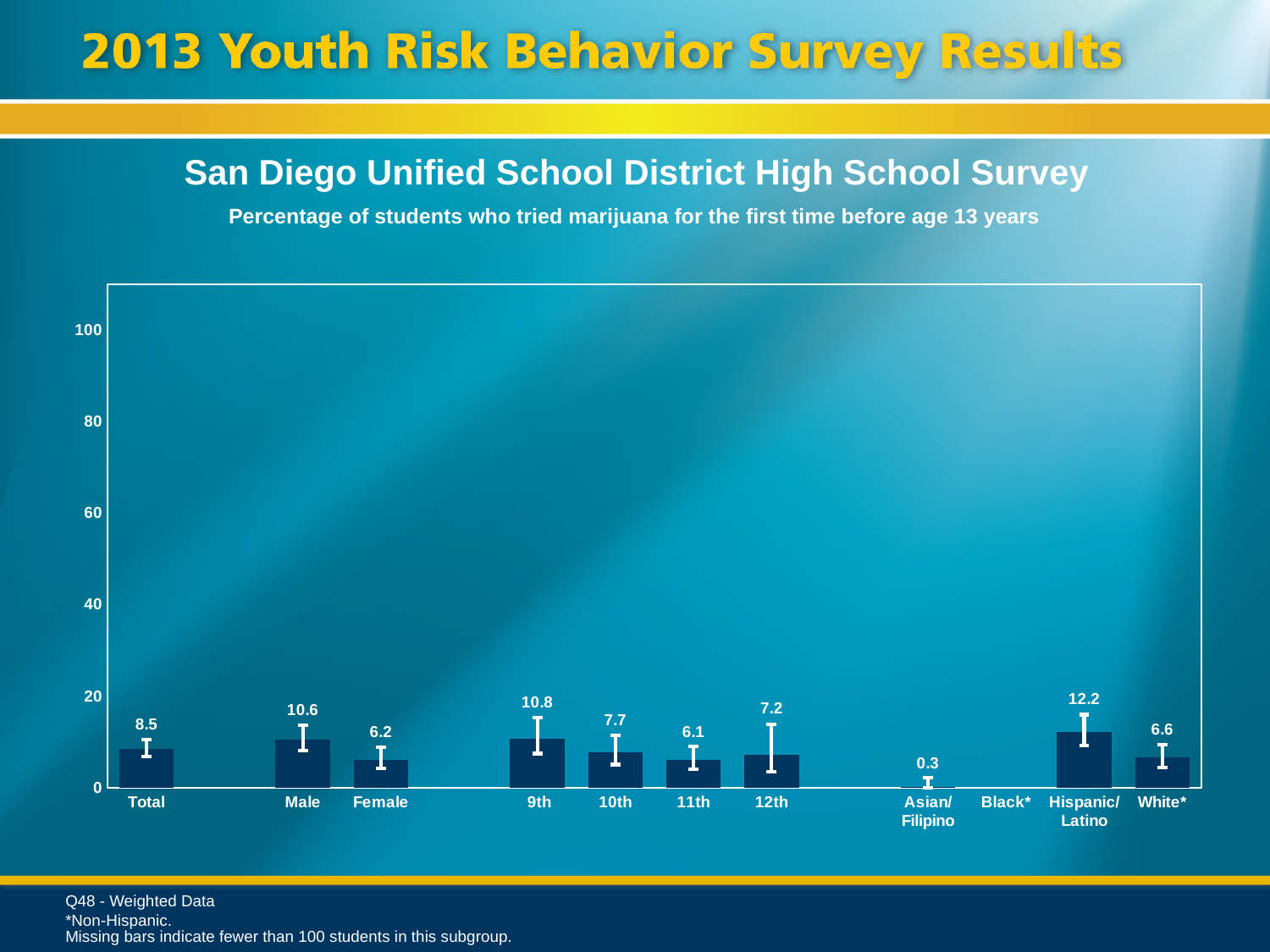
What is the value for Hispanic/Latino? 12.2 Is the value for Hispanic/Latino greater or less than 20? less What is the difference between the Male and Female values? 4.4 What kind of chart is shown? bar chart Which category has no bar shown? Black* Which category has the highest value? Hispanic/Latino How many categories are labelled on the x axis? 12 Which category with a bar has the lowest value? Asian/Filipino What is the value for Asian/Filipino? 0.3 What is the value for Total? 8.5 Which is larger, the value for 9th or the value for 12th? 9th What is the value for Male? 10.6